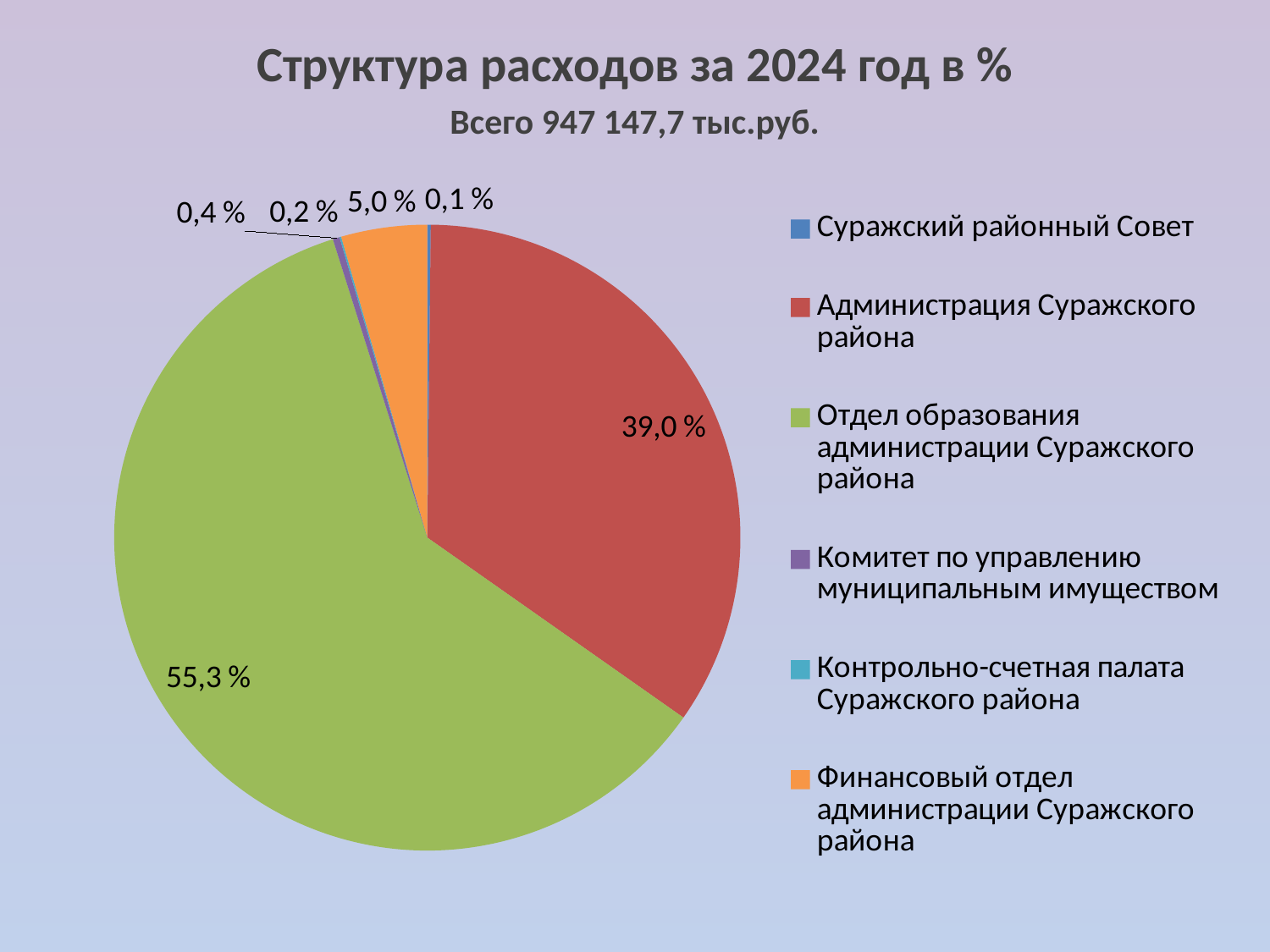
What share of expenses is attributed to Финансовый отдел администрации Суражского района? 5,0 % Which category has the largest share of expenses? Отдел образования администрации Суражского района What share of expenses is attributed to Администрация Суражского района? 39,0 % What is the title of the chart? Структура расходов за 2024 год в % What share of expenses is attributed to Отдел образования администрации Суражского района? 55,3 % How many categories does the legend list? 6 What is the difference in percentage points between the shares of Отдел образования администрации Суражского района and Администрация Суражского района? 16,3 What type of chart is shown on the slide? pie chart What total amount is stated under the chart title? 947 147,7 тыс.руб. Which has a larger share: Комитет по управлению муниципальным имуществом or Контрольно-счетная палата Суражского района? Комитет по управлению муниципальным имуществом